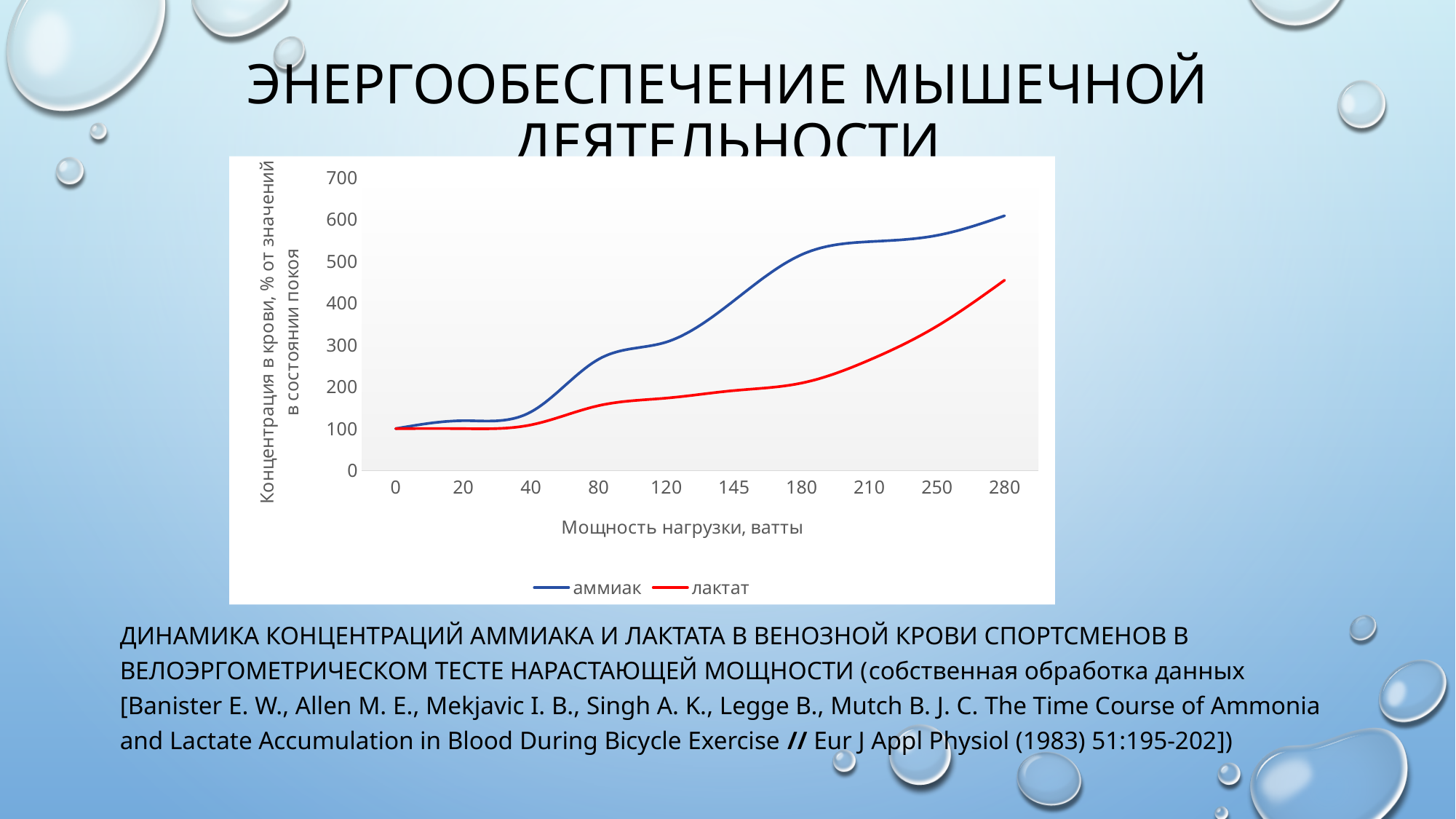
At 210 watts, which series has the larger value, аммиак or лактат? аммиак Do the values for аммиак rise or fall as load power increases along the x axis? rise How many series does the legend list? 2 What is the title of the x axis? Мощность нагрузки, ватты At which load power does the аммиак series reach its highest value? 280 Is the value for лактат at 280 watts greater or less than 500? less Is the value for лактат at 120 watts greater or less than 200? less What kind of chart is shown on the slide? line chart Is the value for аммиак at 180 watts greater or less than 400? greater How many load power values are marked on the x axis? 10 Which series is plotted in blue? аммиак